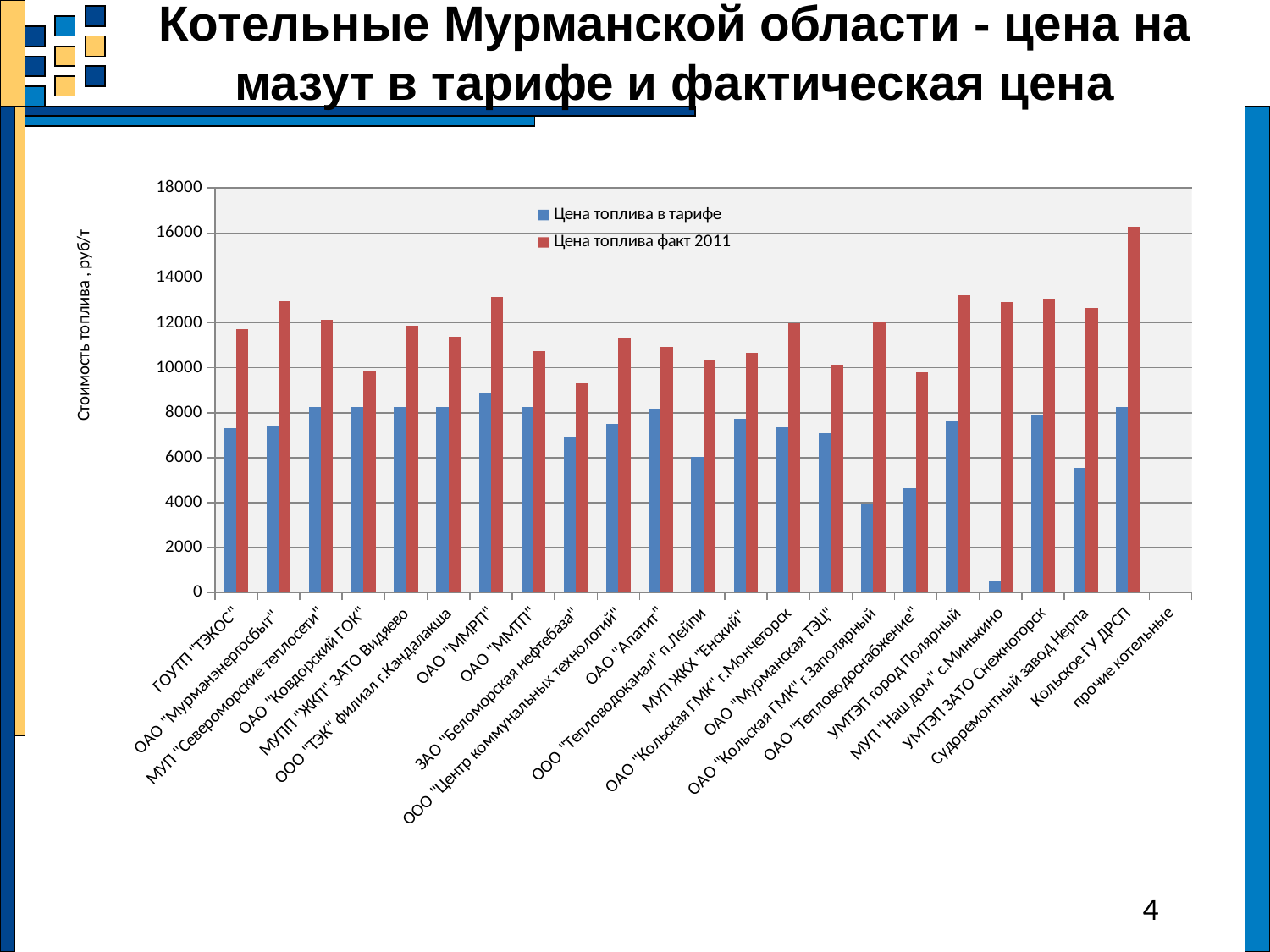
Is the value of "Цена топлива факт 2011" for Кольское ГУ ДРСП greater or less than 14000? greater Is the value of "Цена топлива в тарифе" for ОАО "Тепловодоснабжение" greater or less than 6000? less Which is larger: the "Цена топлива факт 2011" value for ОАО "ММРП" or for ОАО "Апатит"? ОАО "ММРП" How many series does the legend list? 2 What kind of chart is shown on the slide? Bar chart Which category has the lowest value for the series "Цена топлива в тарифе"? МУП "Наш дом" с.Минькино Is the value of "Цена топлива факт 2011" for ГОУТП "ТЭКОС" greater or less than 10000? greater What are the two series named in the legend? Цена топлива в тарифе; Цена топлива факт 2011 Which category has the highest value for the series "Цена топлива факт 2011"? Кольское ГУ ДРСП What is the label of the vertical axis? Стоимость топлива, руб/т For ОАО "Апатит", which series has the larger value: "Цена топлива в тарифе" or "Цена топлива факт 2011"? Цена топлива факт 2011